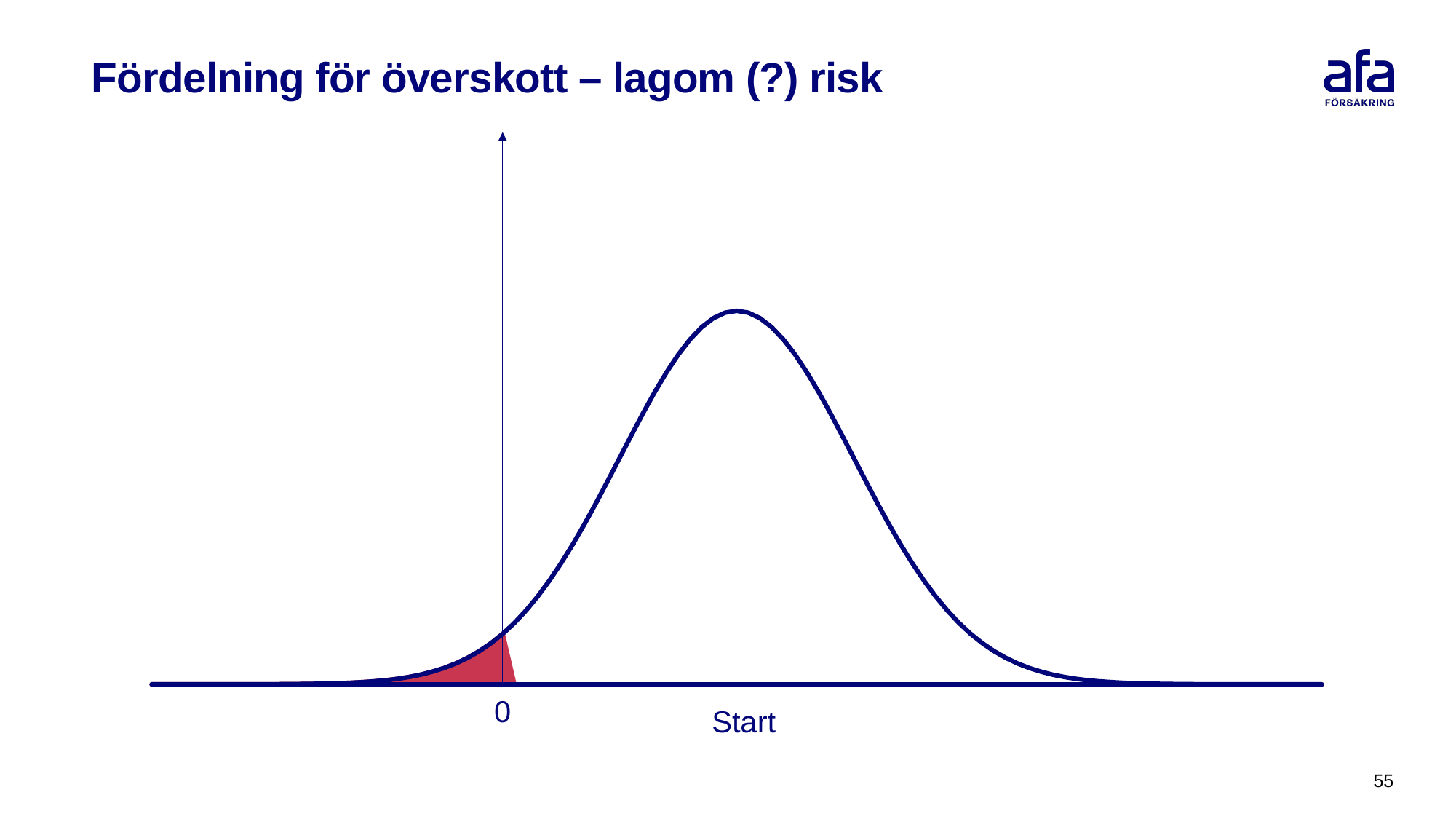
At which x-axis label does the curve reach its peak? Start What is the title of the chart on the slide? Fördelning för överskott – lagom (?) risk Is the curve higher at 0 or at Start? Start Does the curve rise or fall as it moves from 0 towards Start along the x axis? Rise On which side of the 0 mark is the shaded area under the curve? To the left of 0 What kind of chart is shown on the slide? A line chart showing a bell-shaped distribution curve What are the two labels shown on the x axis? 0 and Start Does the curve rise or fall to the right of Start along the x axis? Fall How many labelled tick marks are there on the x axis? 2